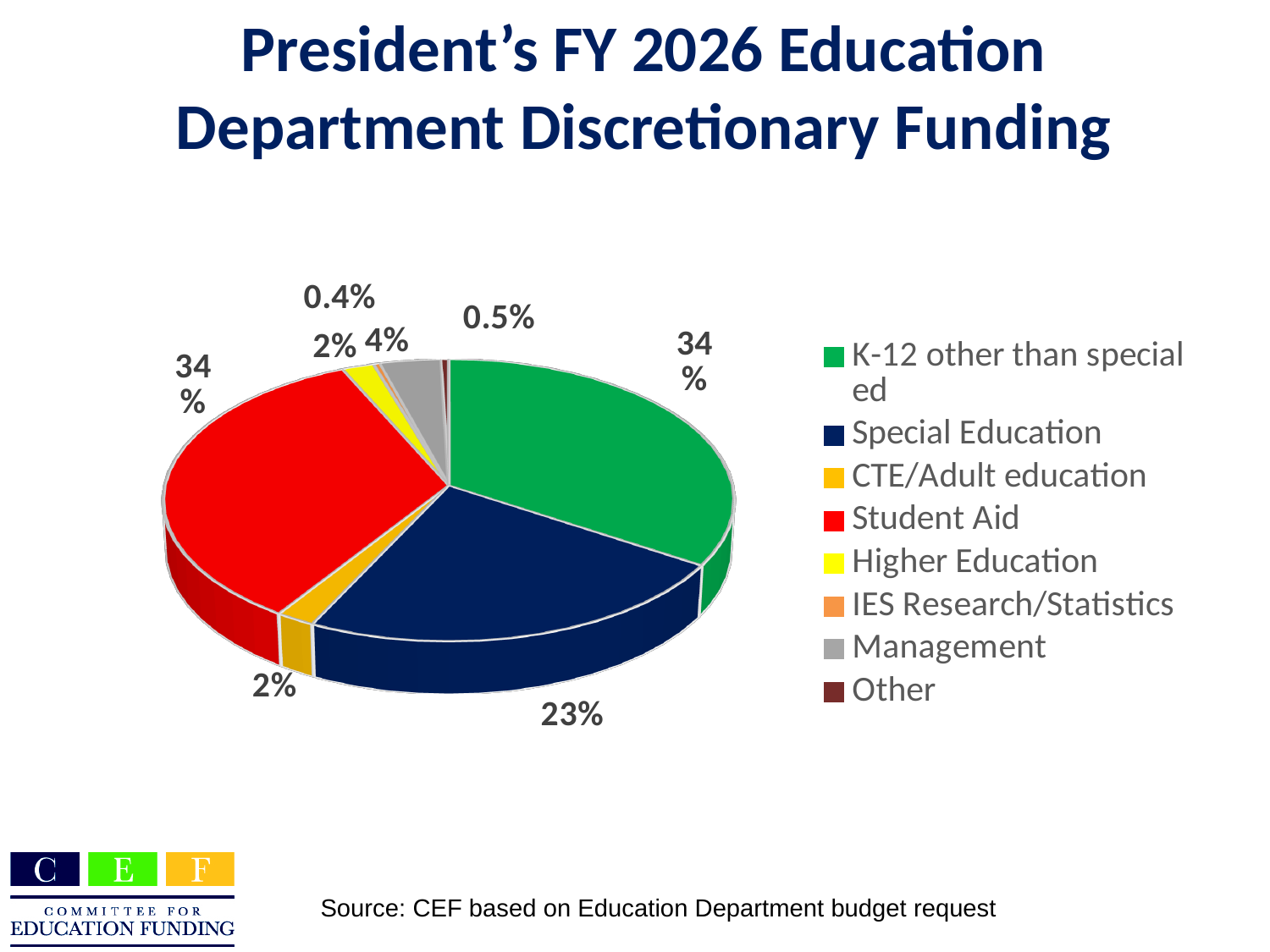
What share of the pie does Special Education represent? 23% How many categories does the legend list? 8 What percentage is shown for CTE/Adult education? 2% Which is larger, the share for Special Education or the share for K-12 other than special ed? K-12 other than special ed What is the difference between the share for Student Aid and the share for Special Education? 11% What colour is the Student Aid slice? red What percentage is shown for Student Aid? 34% What percentage is shown for Management? 4% Which is larger, the share for Management or the share for Higher Education? Management What percentage is shown for K-12 other than special ed? 34% What kind of chart is shown on the slide? pie chart What is the title of the chart? President's FY 2026 Education Department Discretionary Funding